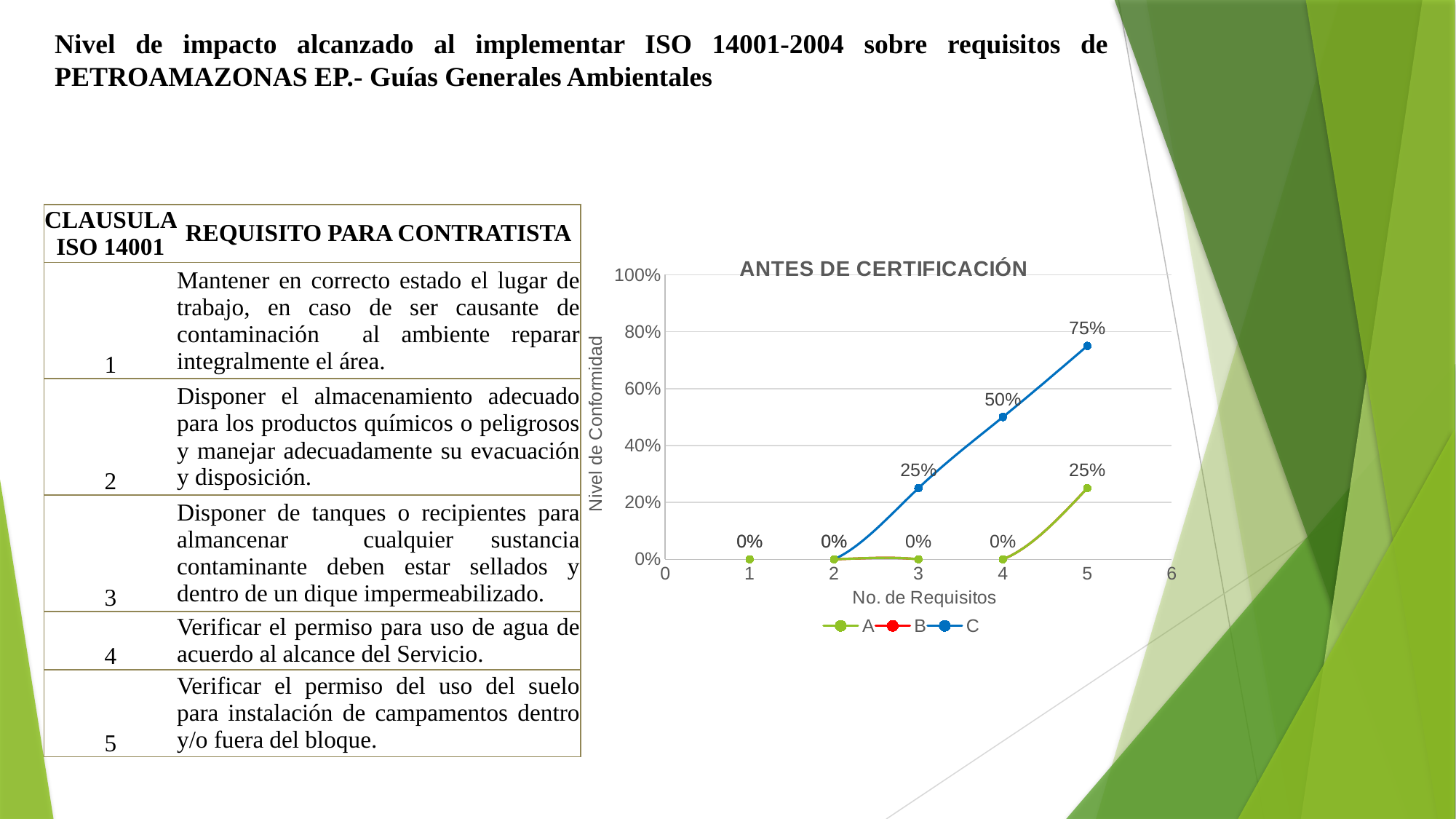
What is the title of the chart? ANTES DE CERTIFICACIÓN What kind of chart is shown on the slide? line chart What is the value of series C at requisito 4? 50% What is the value of series C at requisito 5? 75% What is the value of series C at requisito 3? 25% At which requisito does series C reach its highest value? 5 What is the difference between series C and series A at requisito 5? 50% How many series does the chart legend list? 3 Does series C rise or fall from requisito 2 to requisito 5? rise At requisito 5, which series has the larger value, A or C? C What is the value of series A at requisito 5? 25% What is the label of the vertical axis of the chart? Nivel de Conformidad